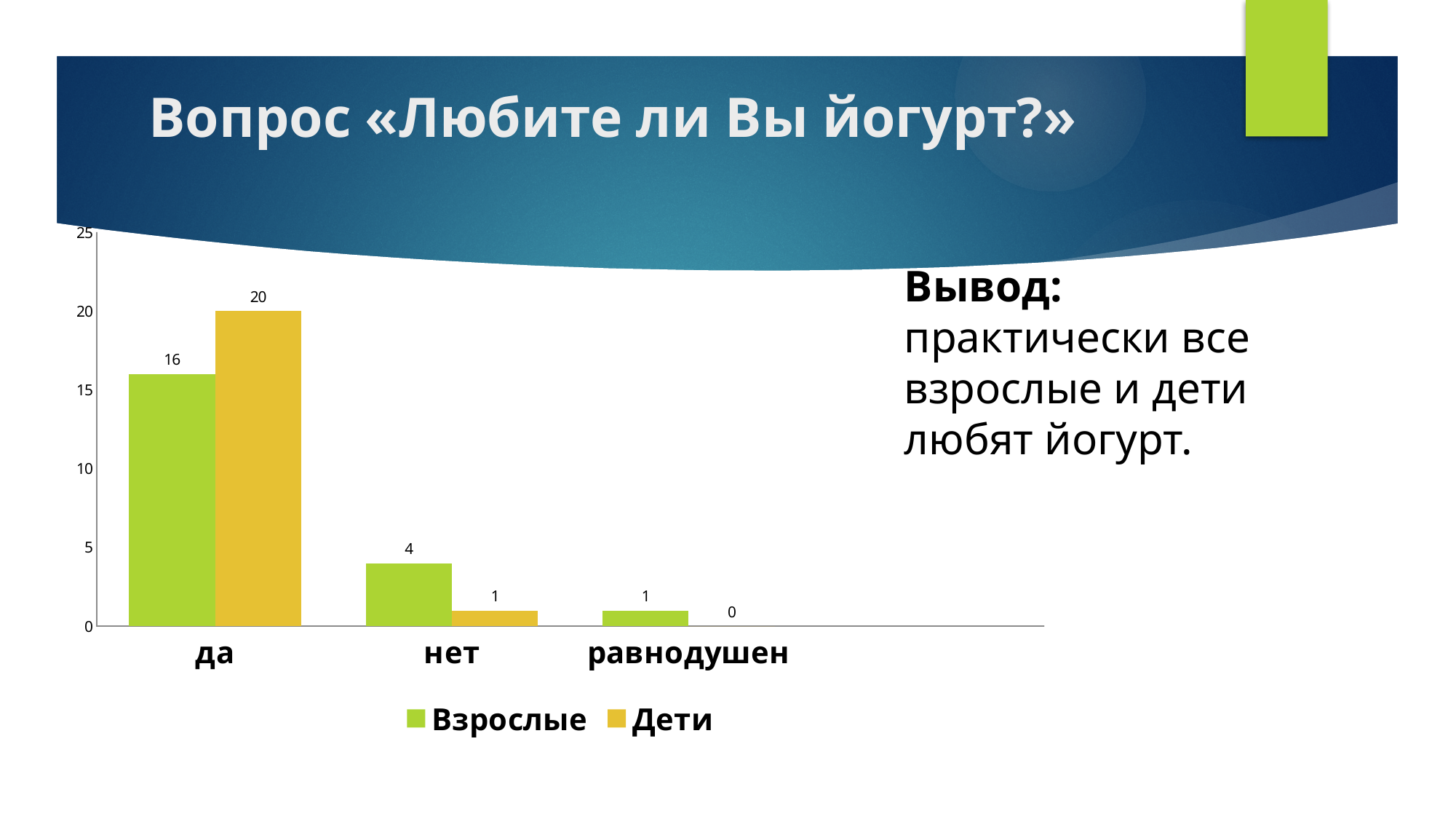
What is the difference between the Дети and Взрослые values in the да category? 4 What colour are the bars for the Дети series? yellow What is the value for Взрослые in the нет category? 4 Which category has the highest value for Дети? да How many categories are shown on the x axis? 3 What is the value for Взрослые in the да category? 16 What is the value for Дети in the да category? 20 How many series does the legend list? 2 In the нет category, which series has the larger value, Взрослые or Дети? Взрослые What is the value for Дети in the равнодушен category? 0 What kind of chart is shown on the slide? bar chart Which category has the lowest value for Взрослые? равнодушен